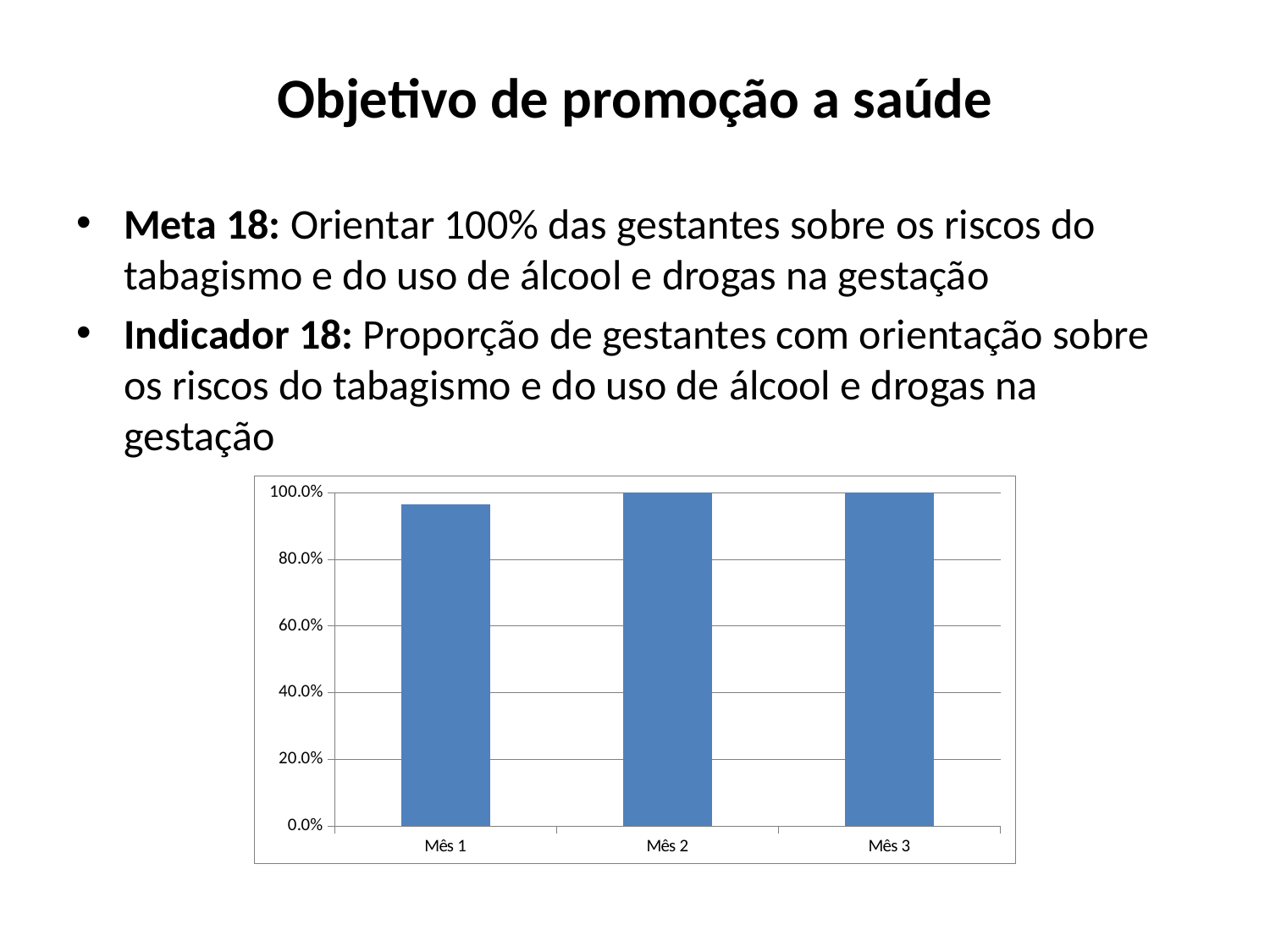
What is the value for Mês 3? 100.0% Does the value rise or fall from Mês 1 to Mês 2? rise How many categories are shown on the x axis of the chart? 3 What kind of chart is shown on the slide? bar chart Which is larger, the value for Mês 1 or the value for Mês 2? Mês 2 Is the value for Mês 1 greater or less than 100.0%? less Which category has the lowest value? Mês 1 What is the value for Mês 2? 100.0% What colour are the bars in the chart? blue What is the highest value labelled on the y axis? 100.0% Is the value for Mês 1 greater or less than 80.0%? greater